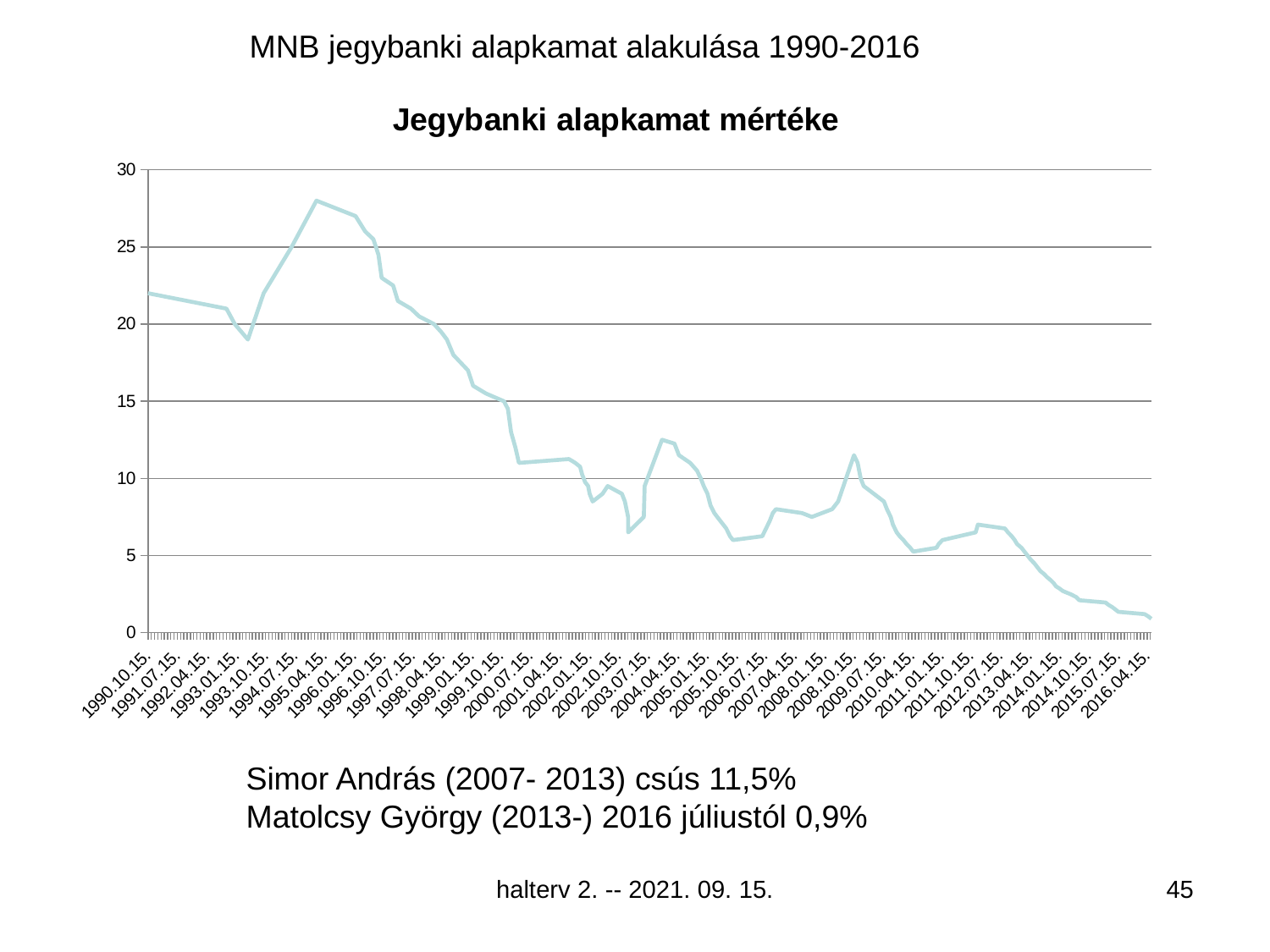
Is the value for 1997.07.15. greater or less than 20? greater What is the highest value shown on the vertical axis of the chart? 30 Is the value for 2016.04.15. greater or less than 5? less Overall, does the line rise or fall from 1990.10.15. to 2016.04.15.? fall Is the value for 2014.10.15. greater or less than 5? less What kind of chart is shown on the slide? line chart Does the line rise or fall between 1993.10.15. and 1995.04.15.? rise What is the title of the chart? Jegybanki alapkamat mértéke